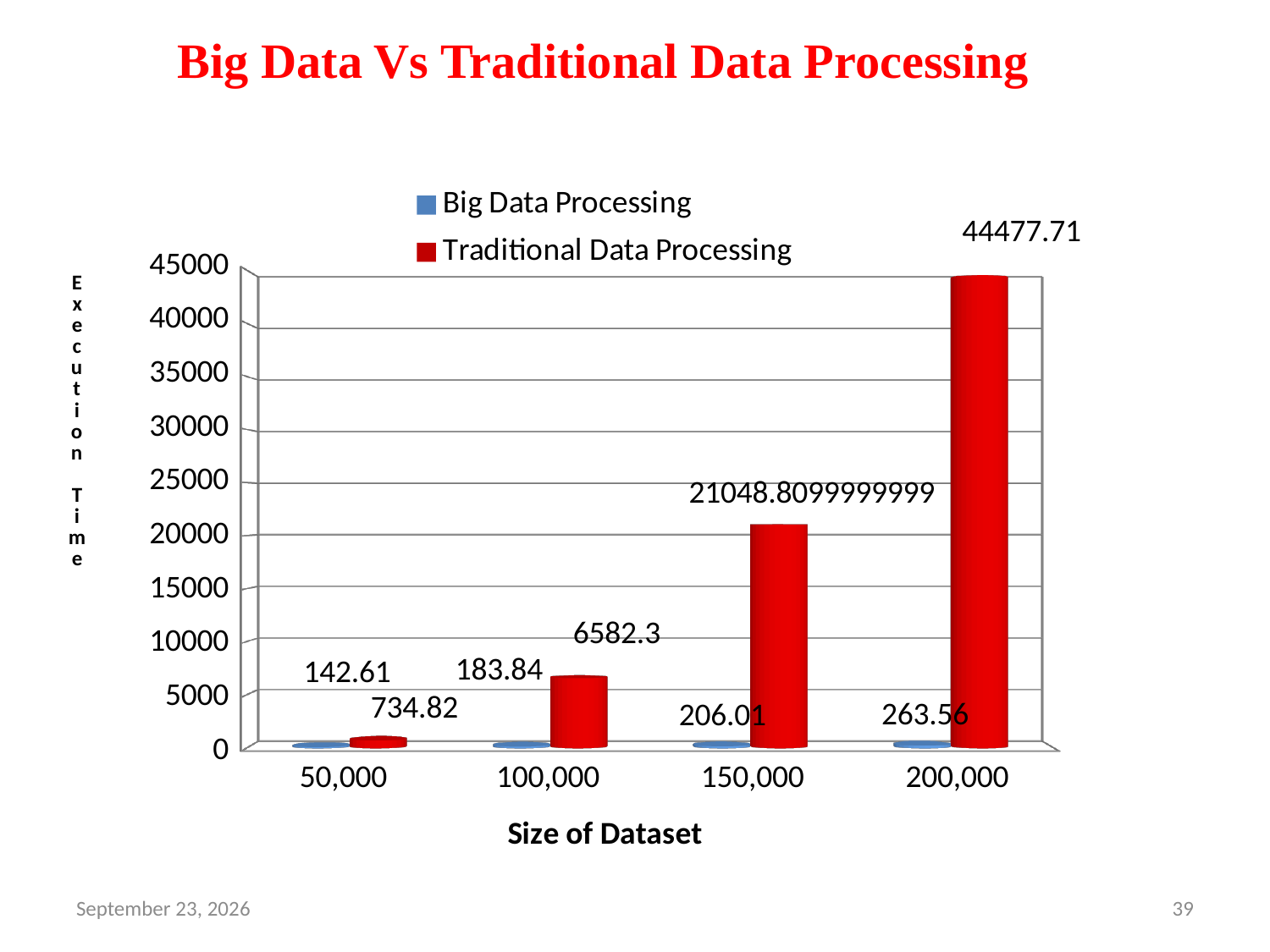
Do the Traditional Data Processing execution times rise or fall as the dataset size increases? rise How many series does the legend list? 2 What is the execution time for Big Data Processing at a dataset size of 150,000? 206.01 What is the execution time for Traditional Data Processing at a dataset size of 200,000? 44477.71 How many dataset sizes are shown on the x axis? 4 Which dataset size has the highest Traditional Data Processing execution time? 200,000 What is the execution time for Big Data Processing at a dataset size of 50,000? 142.61 What is the difference between Traditional Data Processing and Big Data Processing execution times at a dataset size of 50,000? 592.21 Which dataset size has the lowest Big Data Processing execution time? 50,000 What type of chart is shown on the slide? bar chart Which is larger at a dataset size of 200,000: Big Data Processing or Traditional Data Processing? Traditional Data Processing What is the execution time for Traditional Data Processing at a dataset size of 100,000? 6582.3